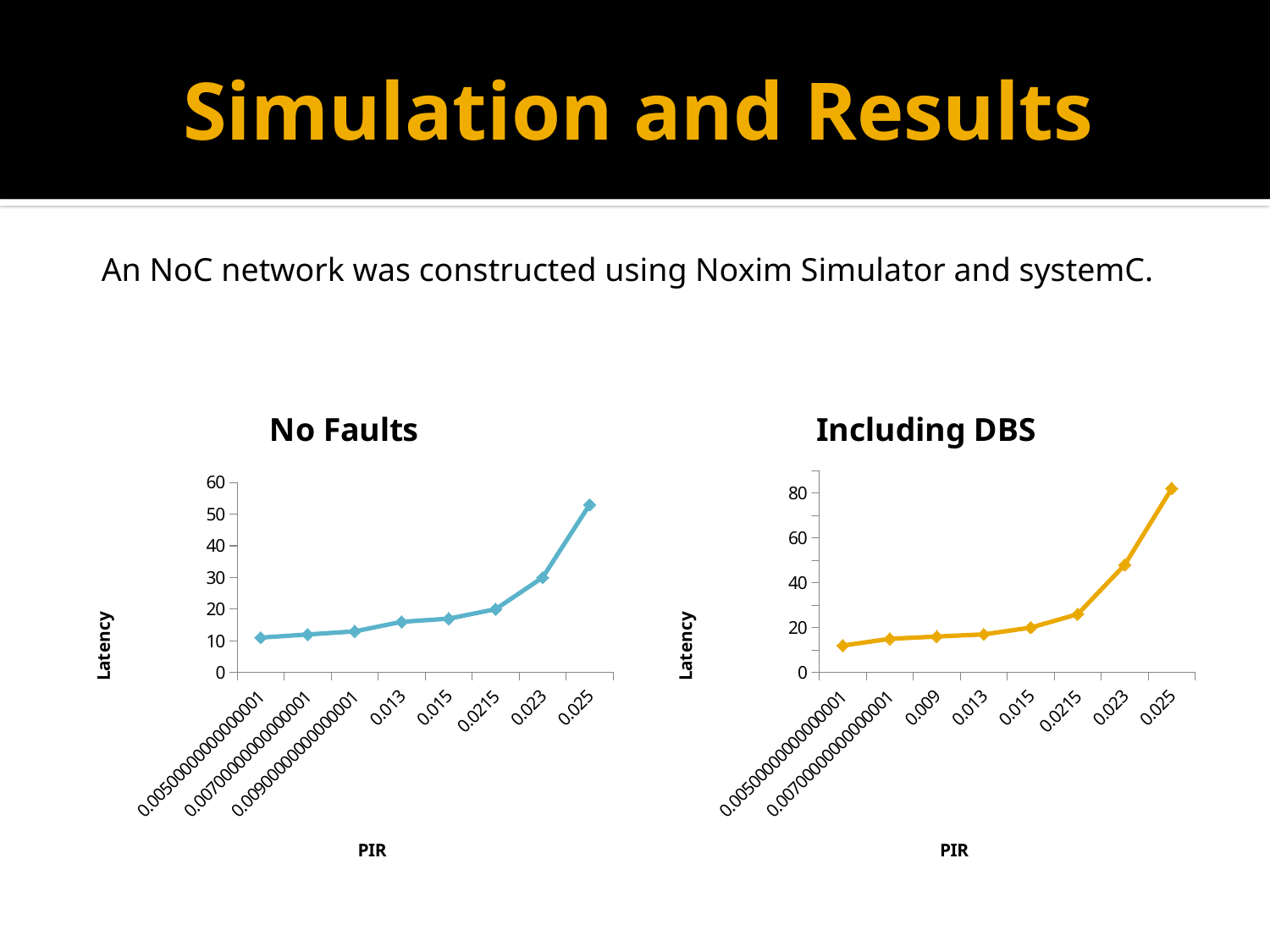
On the "No Faults" chart, at which PIR value is latency lowest? 0.0050000000000000001 On the "Including DBS" chart, is the latency at PIR 0.023 greater or less than 40? greater On the "No Faults" chart, is the latency at PIR 0.013 greater or less than 20? less What type of chart is the "No Faults" chart? line chart On the "No Faults" chart, is the latency at PIR 0.025 greater or less than 40? greater On the "Including DBS" chart, does latency rise or fall as PIR increases along the x axis? rise On the "No Faults" chart, which has the higher latency: PIR 0.023 or PIR 0.015? 0.023 What is the y-axis label on the "Including DBS" chart? Latency How many data points are plotted on the "Including DBS" chart? 8 On the "Including DBS" chart, at which PIR value is latency highest? 0.025 On the "No Faults" chart, at which PIR value is latency highest? 0.025